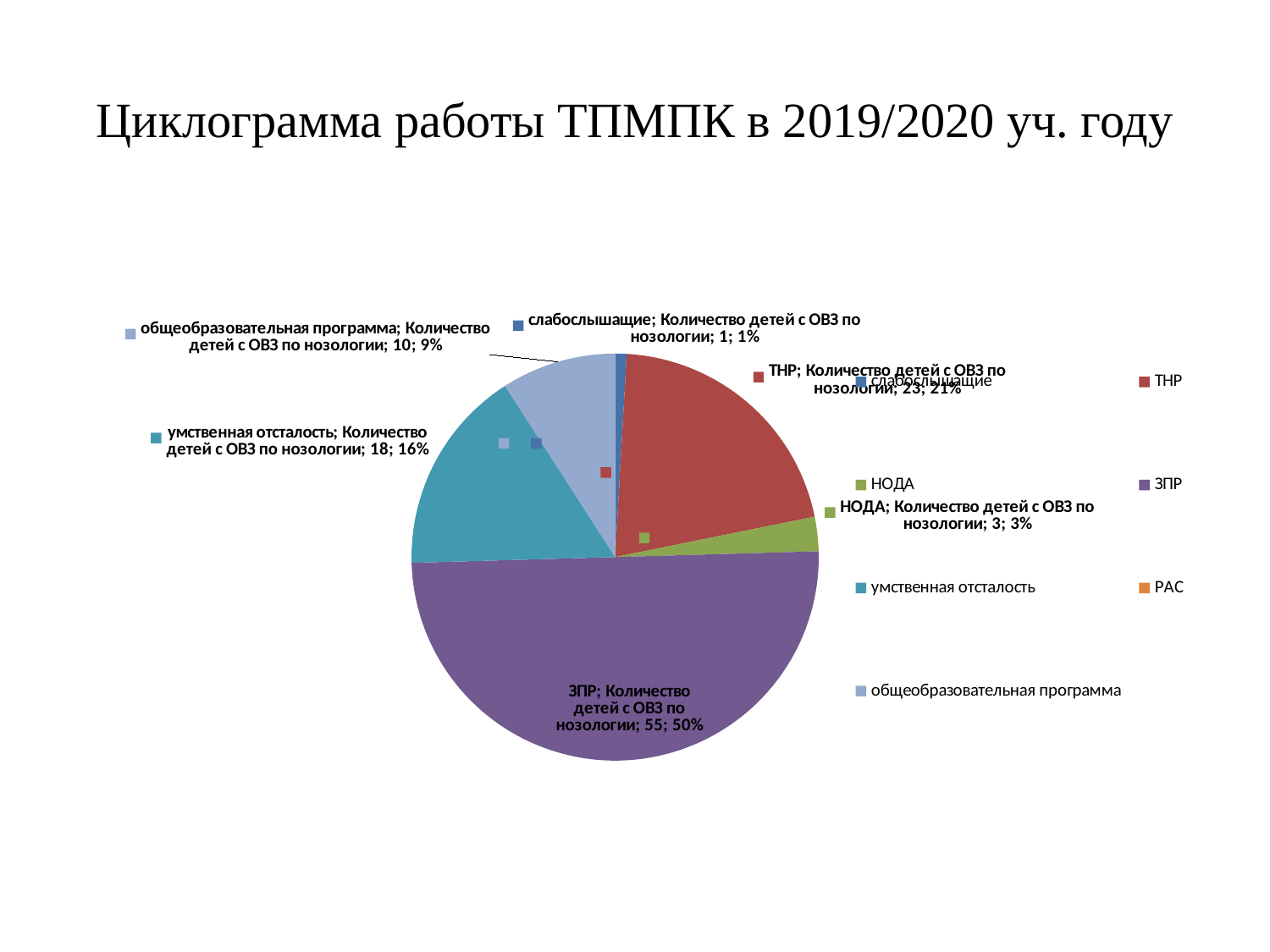
What kind of chart is shown on the slide? pie chart What is the title of the slide? Циклограмма работы ТПМПК в 2019/2020 уч. году Which category has the largest slice of the pie? ЗПР Which is larger, the value for НОДА or the value for умственная отсталость? умственная отсталость What percentage share does общеобразовательная программа have? 9% How many children are in the умственная отсталость category? 18 How many entries does the legend list? 7 How many children with ОВЗ are in the ЗПР category? 55 What percentage share of the pie does ТНР have? 21% What is the value and share shown for НОДА? 3; 3% Which labelled slice has the smallest value? слабослышащие What is the difference between the number of children in ЗПР and in ТНР? 32